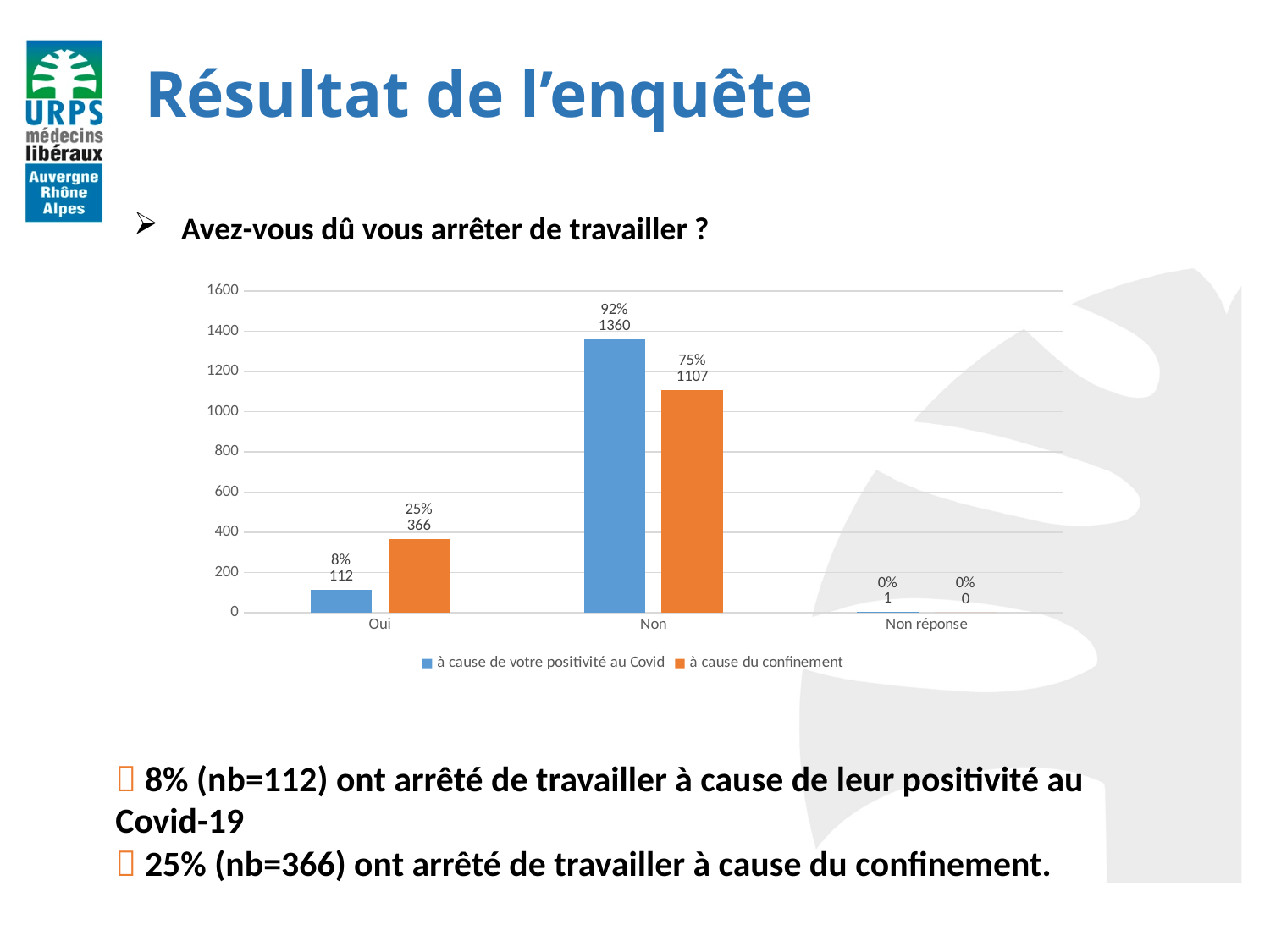
How many series does the legend list? 2 What is the value for 'Oui' in the 'à cause du confinement' series? 366 What is the value for 'Non' in the 'à cause de votre positivité au Covid' series? 1360 What is the difference between the two series' values for 'Non'? 253 Is the value for 'Non' in the 'à cause du confinement' series greater or less than 1000? greater What kind of chart is shown on the slide? bar chart Which category has the highest value in the 'à cause du confinement' series? Non Which category has the lowest value in the 'à cause de votre positivité au Covid' series? Non réponse What is the value for 'Non réponse' in the 'à cause du confinement' series? 0 For 'Oui', which series has the larger value? à cause du confinement What percentage is shown for 'Oui' in the 'à cause de votre positivité au Covid' series? 8% How many categories are shown on the x axis? 3